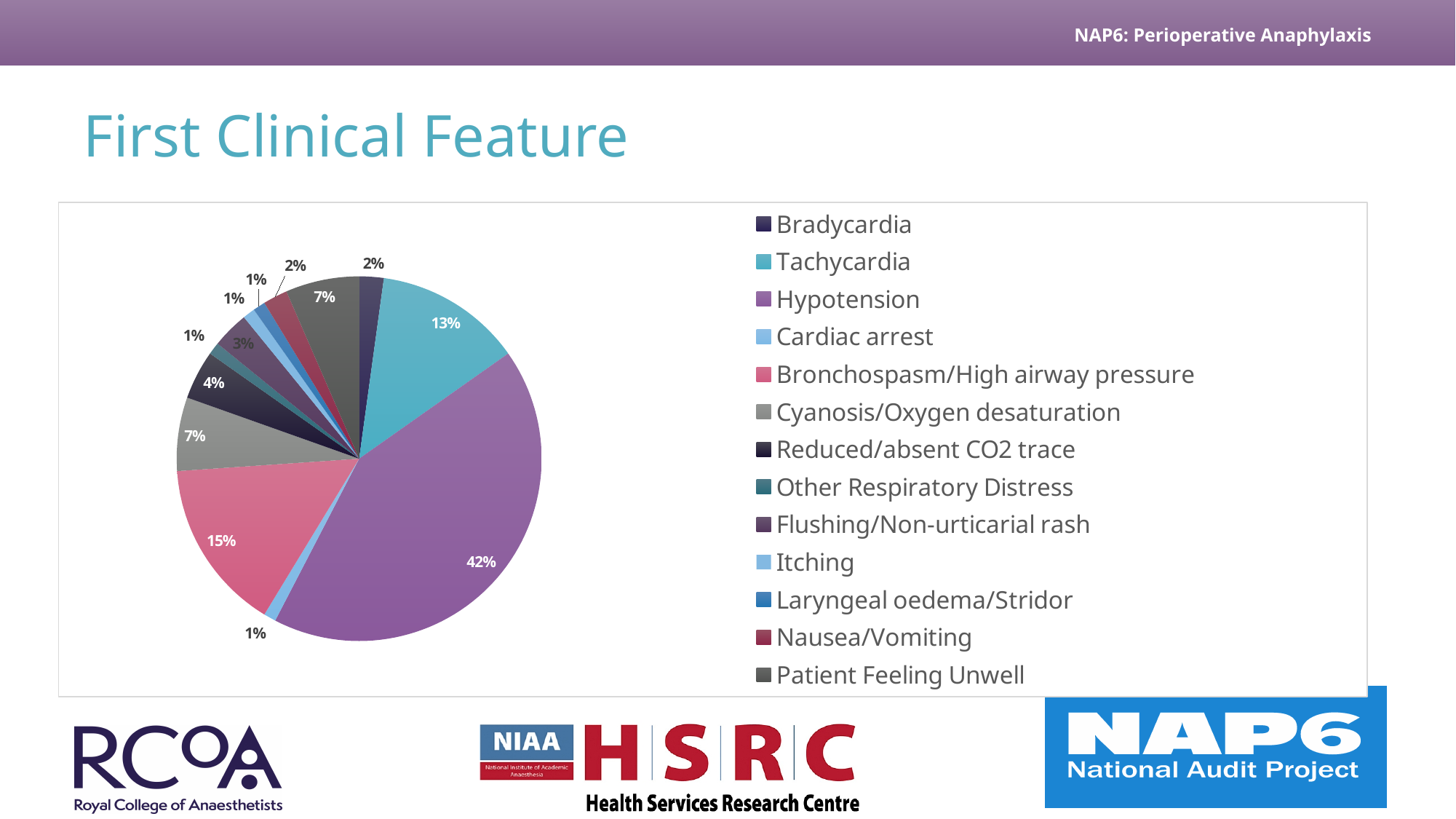
What share of the pie does Hypotension account for? 42% What is the title of the slide? First Clinical Feature Which is larger, the slice for Tachycardia or the slice for Bronchospasm/High airway pressure? Bronchospasm/High airway pressure What is the difference in percentage points between Hypotension and Bronchospasm/High airway pressure? 27 percentage points What is the value shown for Reduced/absent CO2 trace? 4% What is the value shown for Flushing/Non-urticarial rash? 3% What is the value shown for Patient Feeling Unwell? 7% What kind of chart is shown on the slide? Pie chart Which category has the largest slice of the pie? Hypotension How many categories does the legend list? 13 What is the value shown for Bronchospasm/High airway pressure? 15% What is the value shown for Tachycardia? 13%